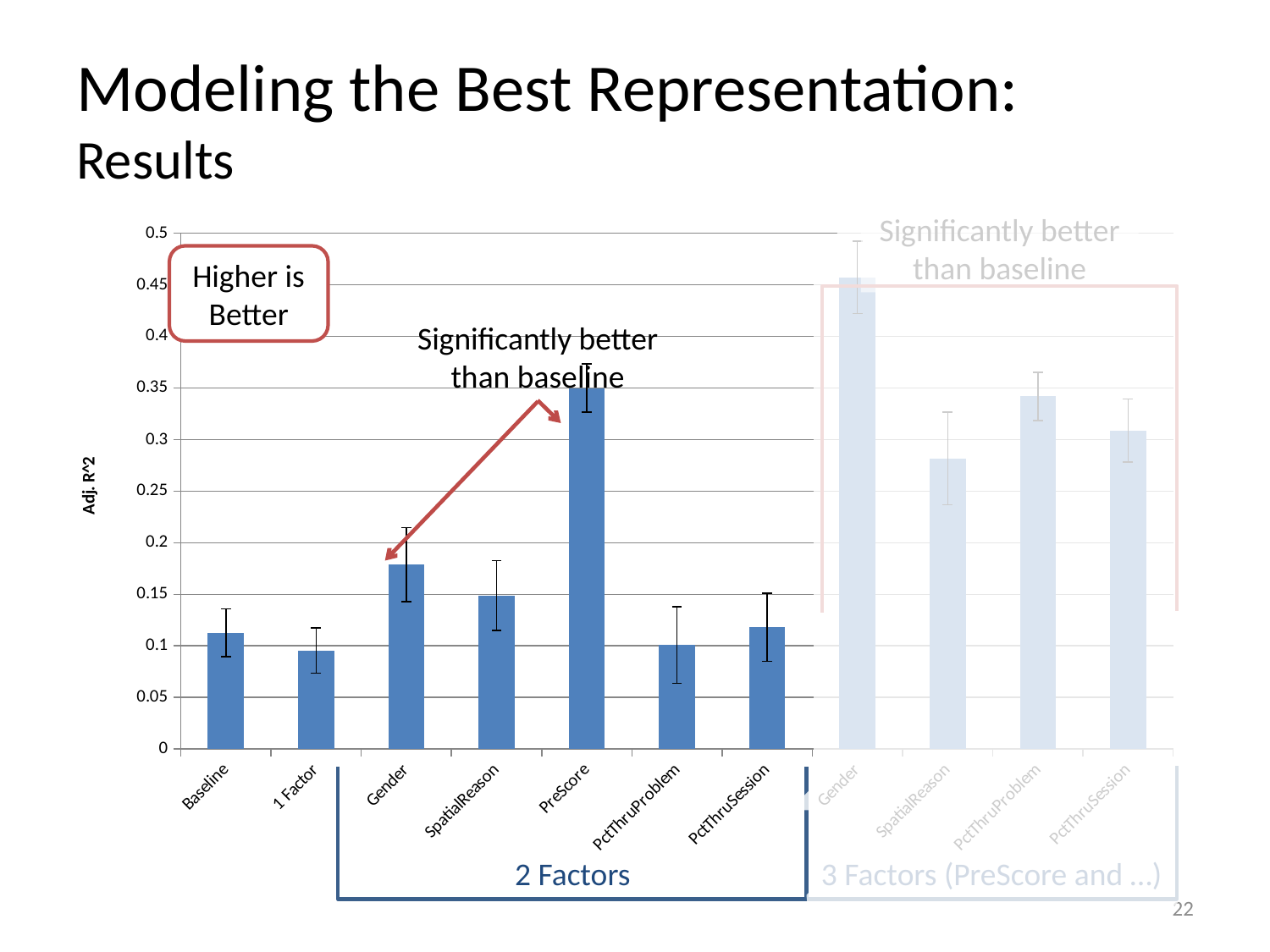
Is the value for Gender in the 2 Factors group greater or less than 0.15? greater Is the value for PctThruProblem in the 3 Factors group greater or less than 0.3? greater How many bars are plotted in the chart? 11 Is the value for PreScore in the 2 Factors group greater or less than 0.3? greater Which is larger: PreScore in the 2 Factors group or Gender in the 2 Factors group? PreScore Which is larger: Gender in the 3 Factors group or PreScore in the 2 Factors group? Gender (3 Factors group) What is the label of the vertical axis? Adj. R^2 What kind of chart is shown on the slide? bar chart Which bar has the highest value in the chart? Gender (3 Factors group) What does the red callout box at the top left of the chart say? Higher is Better